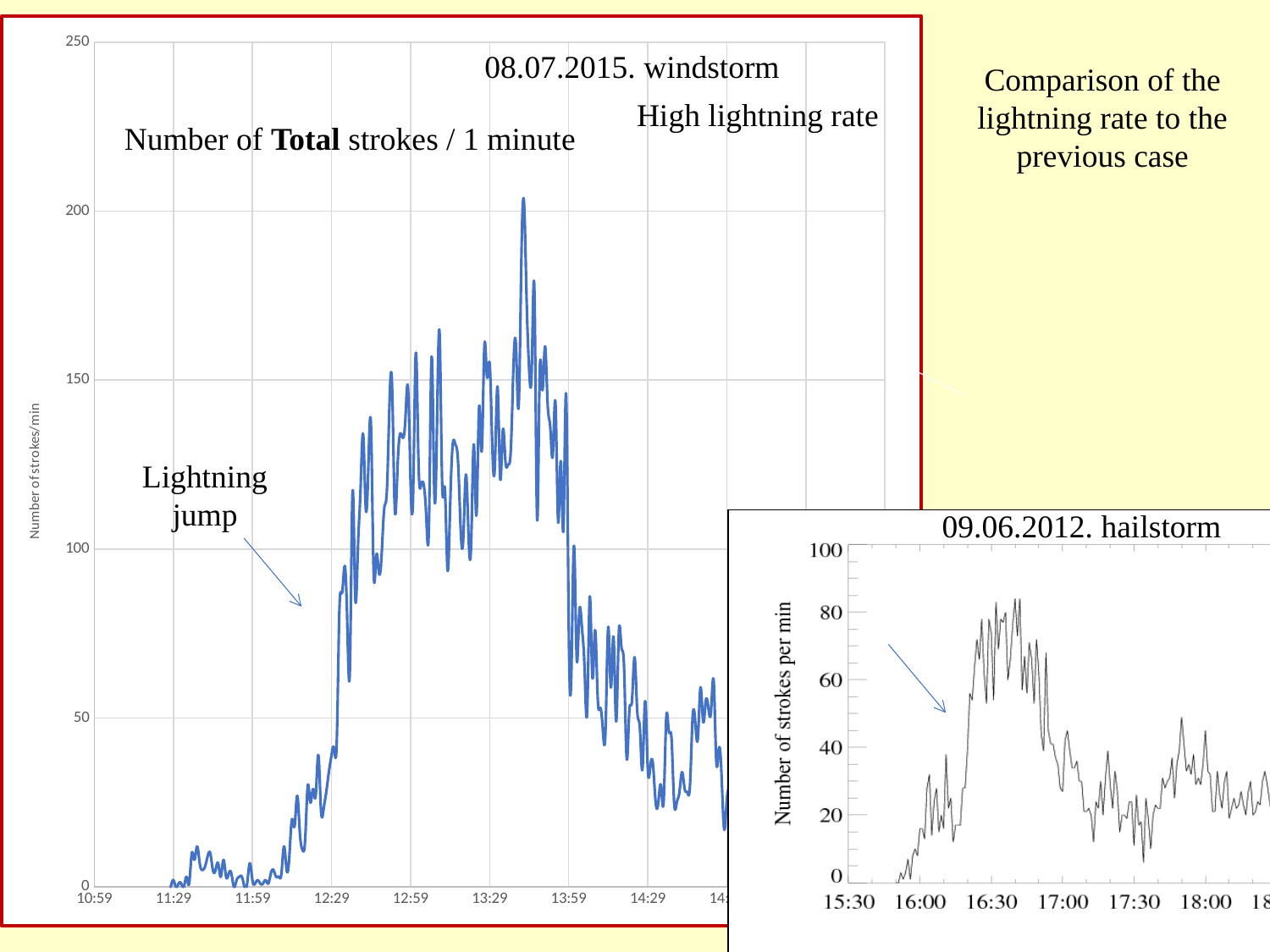
What kind of chart is the 09.06.2012 hailstorm chart in the lower right? line chart Which chart shows the higher peak lightning rate, the 08.07.2015 windstorm chart or the 09.06.2012 hailstorm chart? 08.07.2015 windstorm In the 09.06.2012 hailstorm chart, is the peak number of strokes per minute greater or less than 100? less In the 08.07.2015 windstorm chart, do the values generally rise or fall between 13:59 and 14:29? fall In the 08.07.2015 windstorm chart, is the value at 13:29 greater or less than 100? greater In the 08.07.2015 windstorm chart, is the peak number of strokes per minute greater or less than 150? greater What is the y-axis label of the 09.06.2012 hailstorm chart? Number of strokes per min What kind of chart is the 08.07.2015 windstorm chart on the left? line chart What is the title of the 08.07.2015 windstorm chart? Number of Total strokes / 1 minute